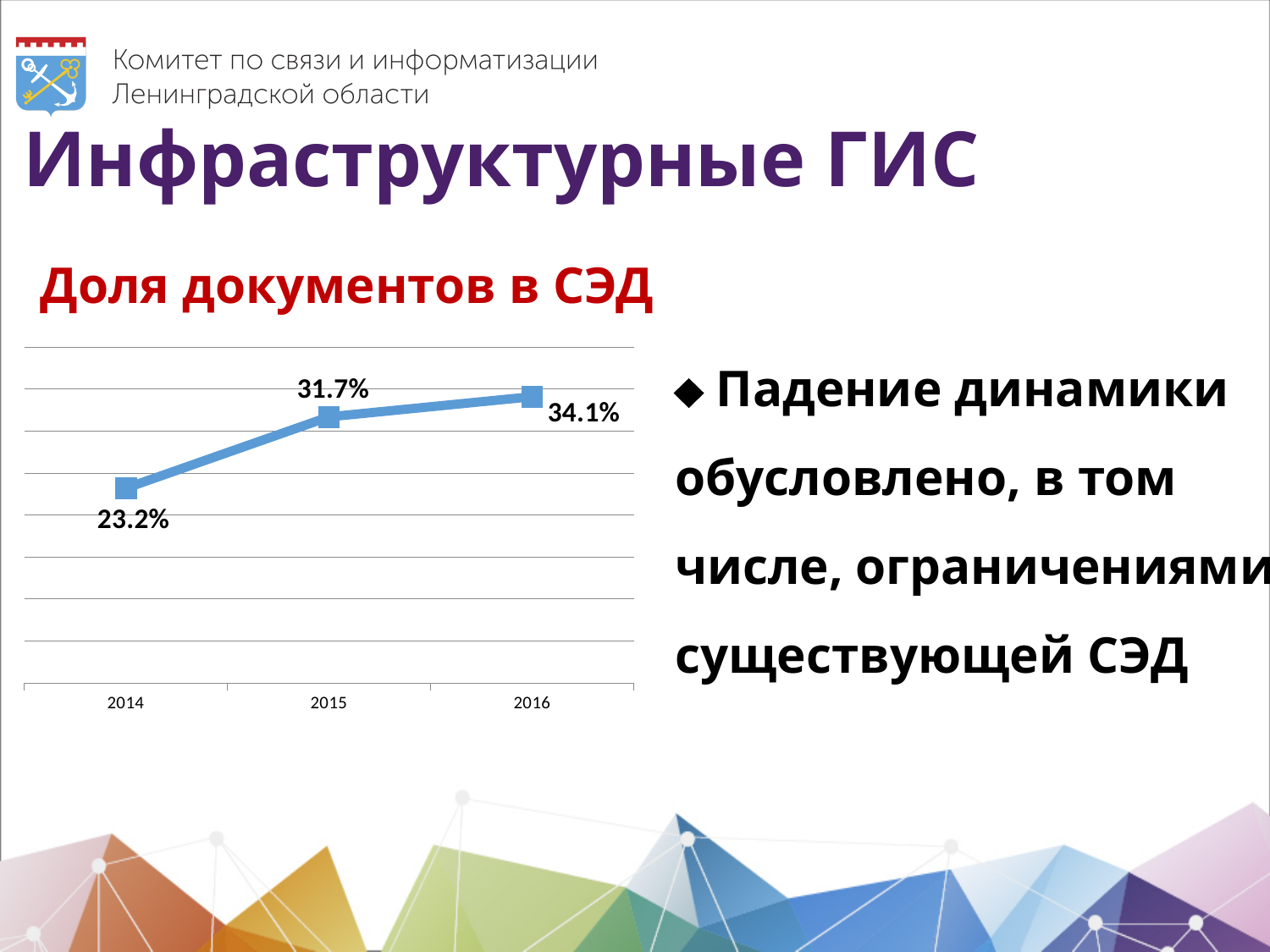
What is the value for 2016? 34.1% What is the title of the chart? Доля документов в СЭД What is the difference between the values for 2016 and 2015? 2.4% What kind of chart is shown on the slide? line chart Which year has the highest value? 2016 What is the difference between the values for 2015 and 2014? 8.5% Do the values rise or fall from 2014 to 2016? rise What is the value for 2014? 23.2% What is the value for 2015? 31.7% Which is larger, the value for 2015 or the value for 2016? 2016 Which year has the lowest value? 2014 How many data points are plotted on the chart? 3